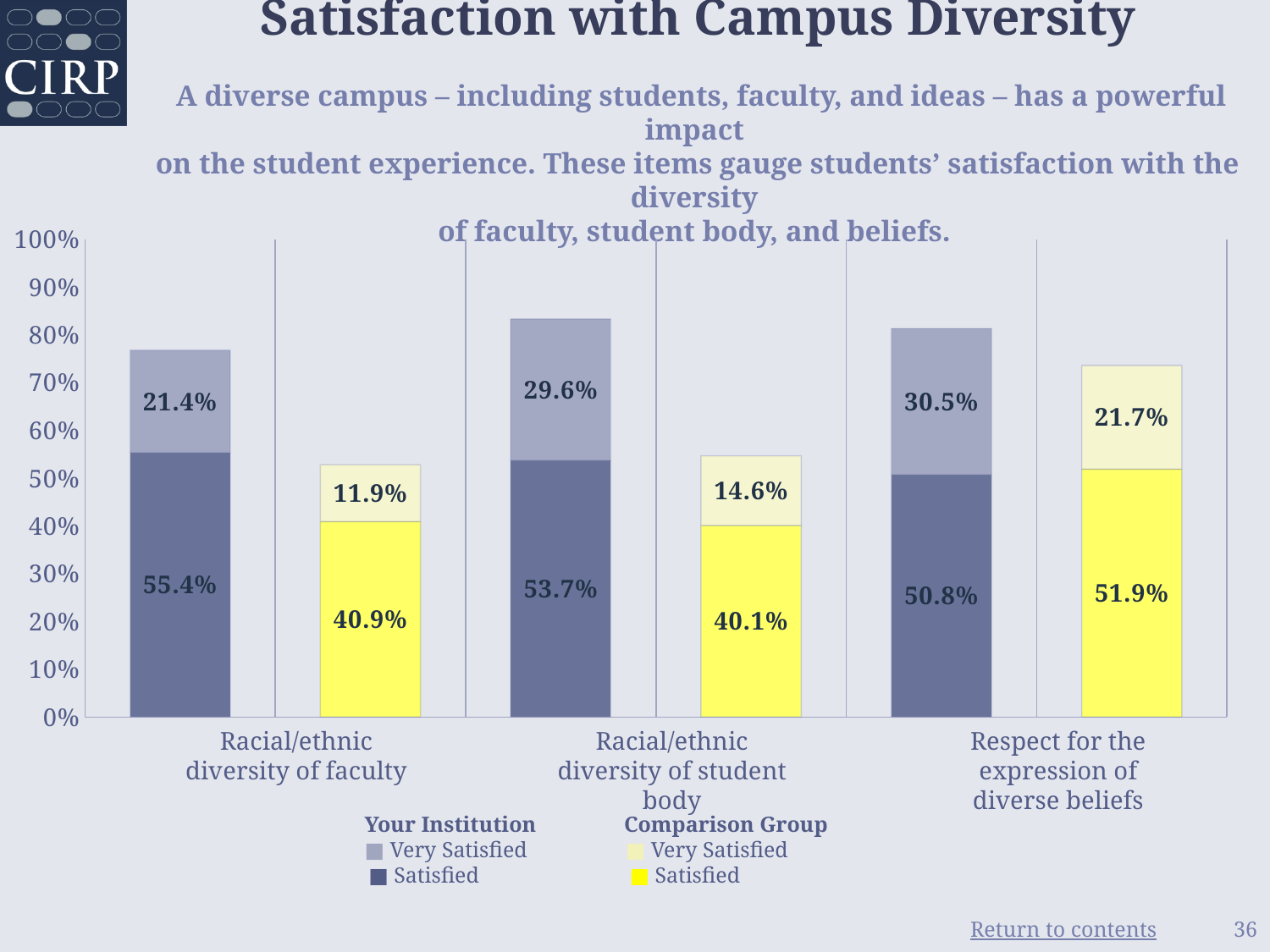
What percentage of Your Institution students were Satisfied with racial/ethnic diversity of faculty? 55.4% How many items (categories) are shown on the x axis of the chart? 3 For respect for the expression of diverse beliefs, which group has the larger Satisfied percentage, Your Institution or the Comparison Group? Comparison Group Which item has the lowest Very Satisfied percentage for the Comparison Group? Racial/ethnic diversity of faculty What is the combined Satisfied plus Very Satisfied total for the Comparison Group on racial/ethnic diversity of faculty? 52.8% What is the difference between the Your Institution and Comparison Group Very Satisfied percentages for racial/ethnic diversity of student body? 15.0% What is the combined Satisfied plus Very Satisfied total for Your Institution on racial/ethnic diversity of student body? 83.3% What percentage of the Comparison Group were Very Satisfied with racial/ethnic diversity of student body? 14.6% What type of chart is shown on the slide? Stacked bar chart How many series does the legend list? 4 What percentage of the Comparison Group were Satisfied with respect for the expression of diverse beliefs? 51.9% Across the three items, which item has the highest Very Satisfied percentage for Your Institution? Respect for the expression of diverse beliefs